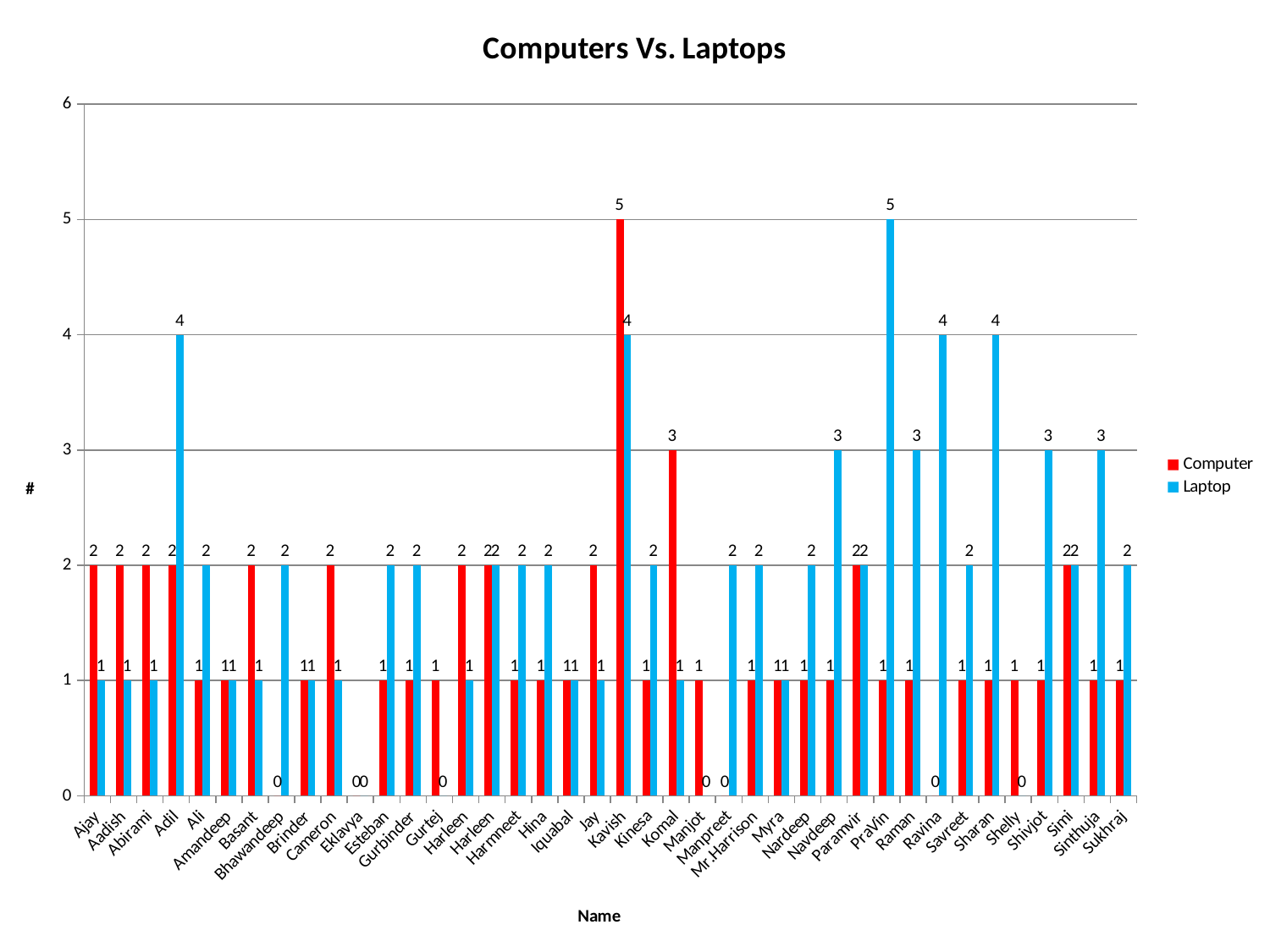
What is the difference between the Laptop value for Sharan and the Laptop value for Savreet? 2 Which is larger for Kavish, the Computer value or the Laptop value? Computer Which name has the highest Laptop value? PraVin How many series does the legend list? 2 Which name has the highest Computer value? Kavish What is the Computer value for Komal? 3 What is the Laptop value for PraVin? 5 What kind of chart is shown? Bar chart What is the Laptop value for Adil? 4 What is the Computer value for Kavish? 5 Which is larger for Navdeep, the Computer value or the Laptop value? Laptop What is the title of the chart? Computers Vs. Laptops